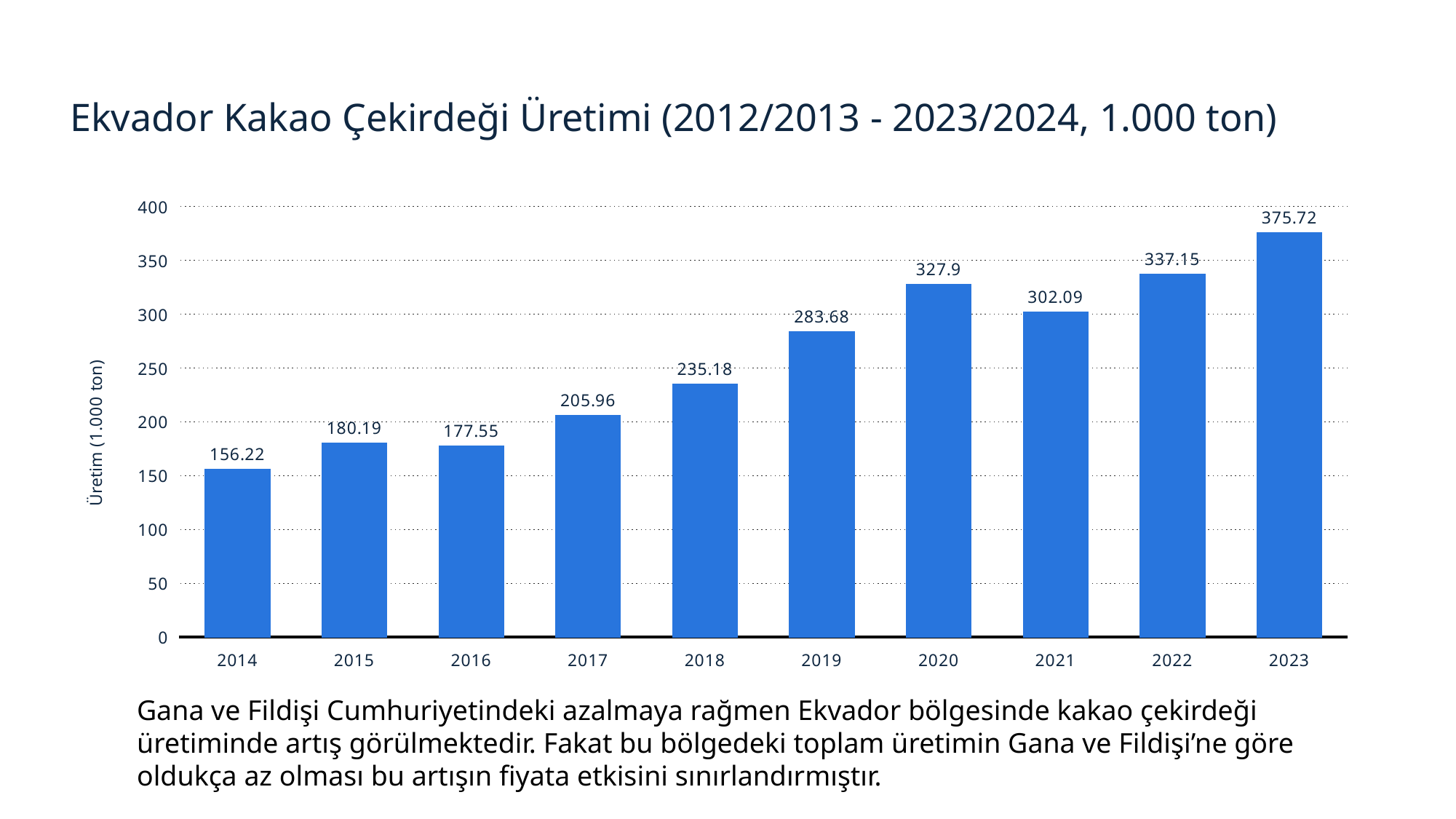
What is the value for 2014? 156.22 Which is larger, the value for 2021 or the value for 2022? 2022 What is the value for 2023? 375.72 Is the value for 2019 greater or less than 250? greater How many years are shown on the x axis? 10 Which year has the highest value? 2023 What is the difference between the values for 2023 and 2014? 219.5 What is the value for 2020? 327.9 Do the values generally rise or fall from 2014 to 2023? rise Which year has the lowest value? 2014 What kind of chart is shown on the slide? bar chart What is the difference between the values for 2020 and 2021? 25.81